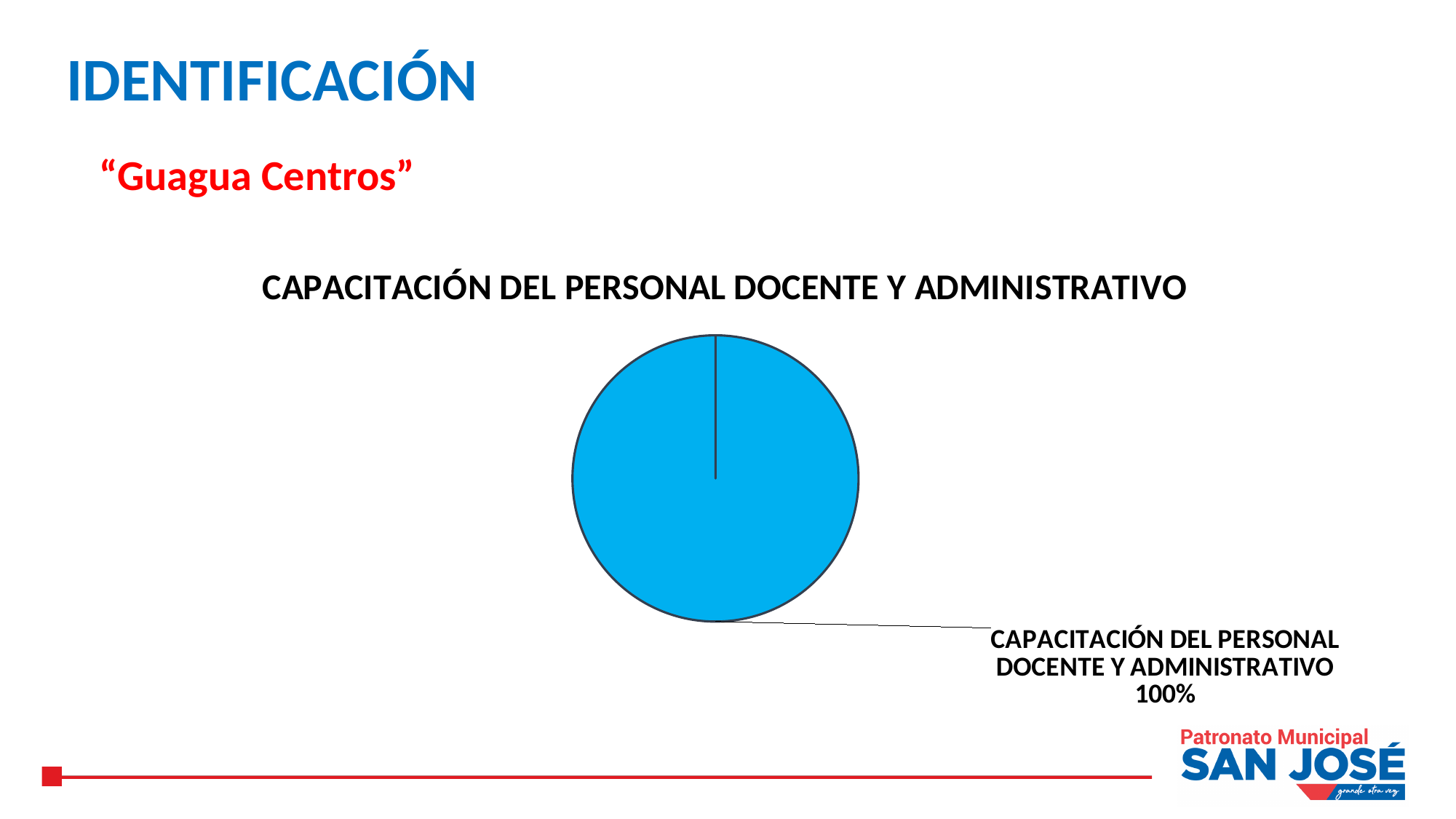
How many slices does the pie chart have? 1 What is the title of the chart? CAPACITACIÓN DEL PERSONAL DOCENTE Y ADMINISTRATIVO What share of the pie does the slice labelled CAPACITACIÓN DEL PERSONAL DOCENTE Y ADMINISTRATIVO represent? 100% Is the value for CAPACITACIÓN DEL PERSONAL DOCENTE Y ADMINISTRATIVO greater or less than 50%? greater What kind of chart is shown on the slide? pie chart What percentage is printed on the data label of the pie chart? 100% What colour is the slice in the pie chart? blue